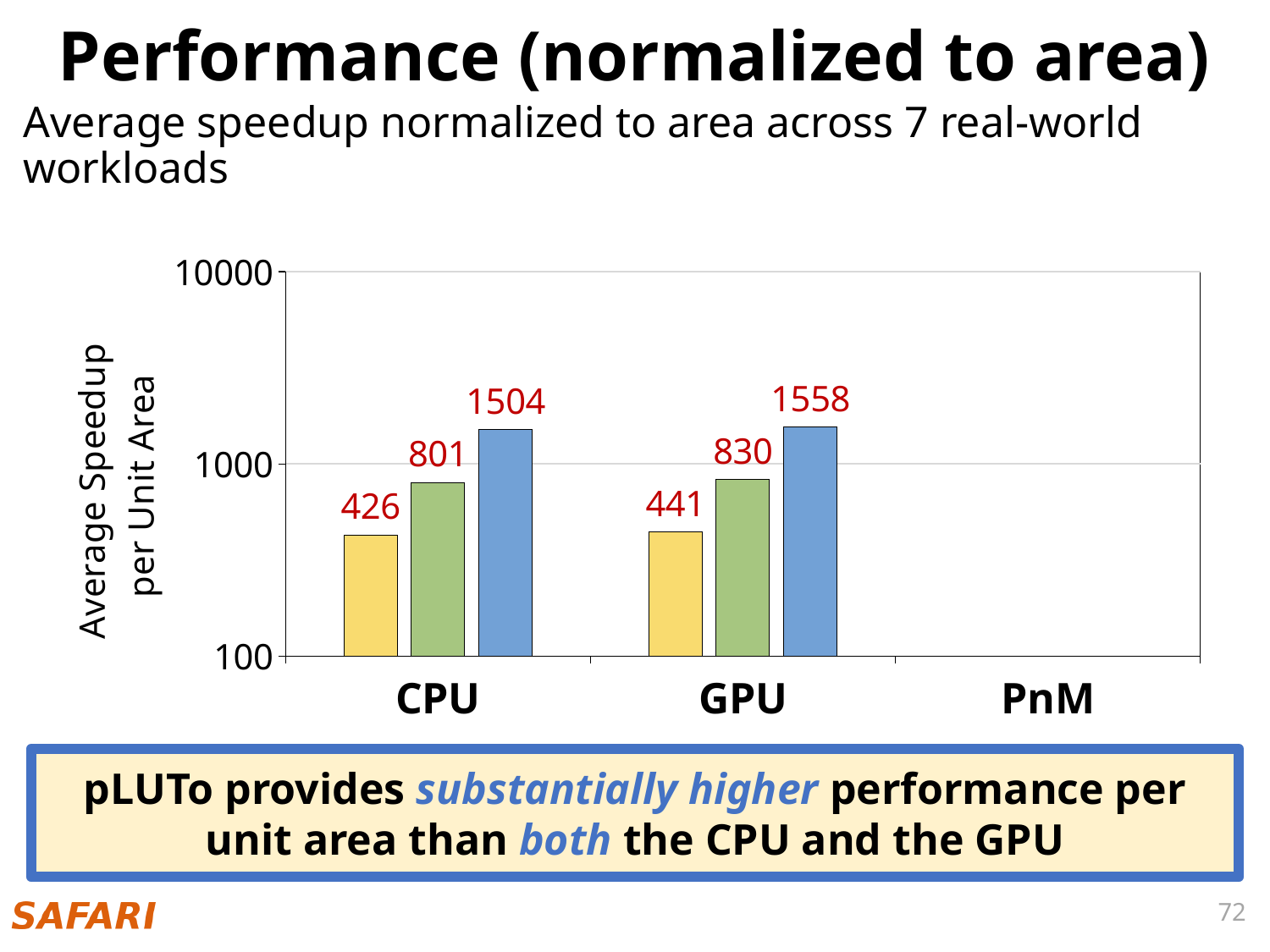
What is the difference between the blue bar and the yellow bar for CPU? 1078 What is the difference between the blue bar for GPU and the blue bar for CPU? 54 What is the value of the green bar for CPU? 801 Which bar has the highest value on the chart? The blue bar for GPU (1558) How many categories are labelled on the x axis? 3 Which bar has the lowest value on the chart? The yellow bar for CPU (426) What is the value of the green bar for GPU? 830 What is the value of the yellow bar for CPU? 426 What is the label of the y axis? Average Speedup per Unit Area Which is larger, the yellow bar for GPU or the yellow bar for CPU? The yellow bar for GPU (441) What is the value of the blue bar for GPU? 1558 What kind of chart is shown on the slide? Bar chart